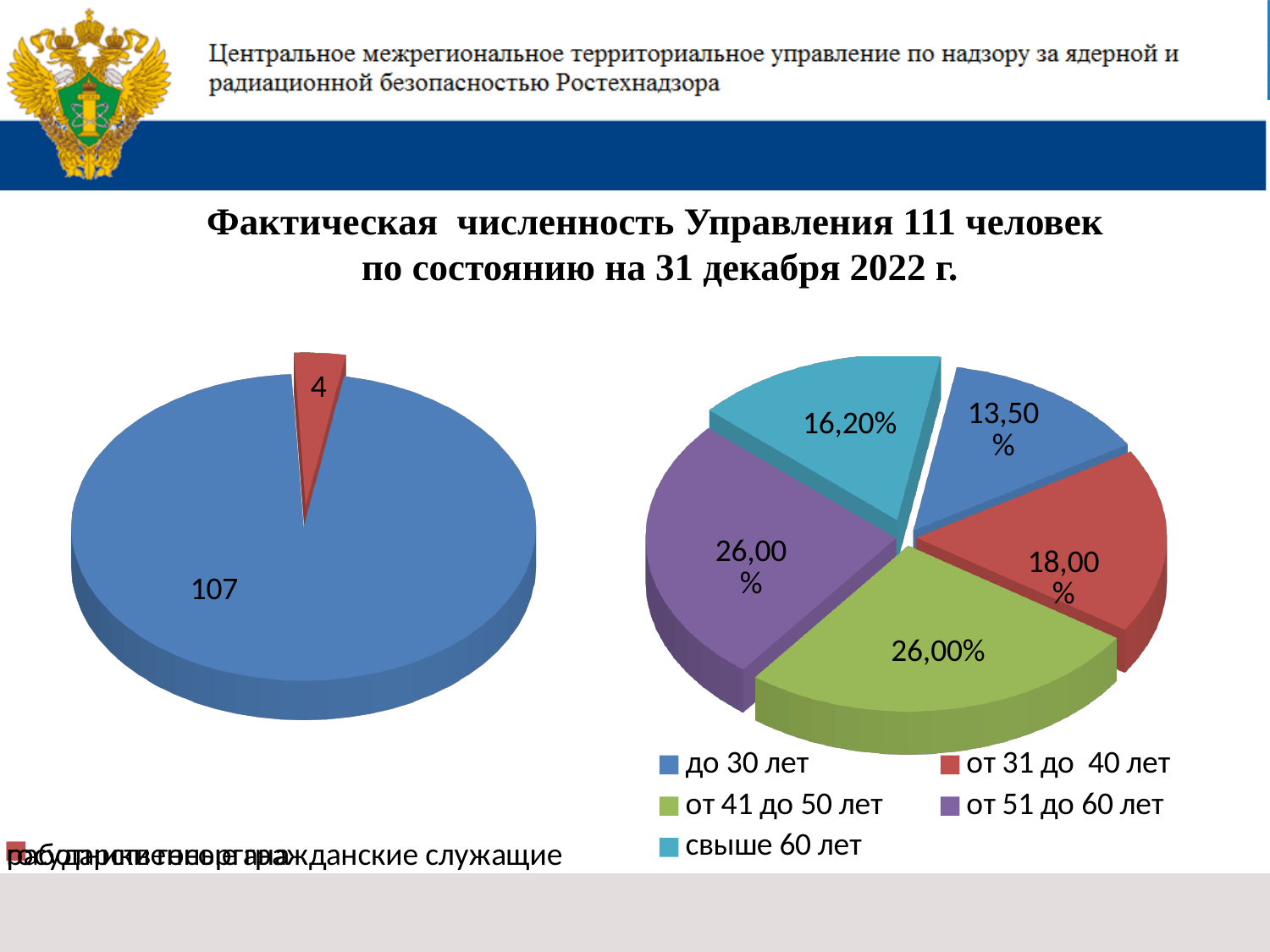
In the right pie chart, what is the share for 'свыше 60 лет'? 16,20% In the right pie chart, which is larger: the share for 'от 31 до 40 лет' or the share for 'свыше 60 лет'? от 31 до 40 лет What kind of chart is the chart on the right of the slide? pie chart In the right pie chart, what is the share for 'от 41 до 50 лет'? 26,00% In the left pie chart, what is the total of the two slices? 111 In the left pie chart, what value is shown on the small red slice? 4 In the right pie chart, which age group has the smallest share? до 30 лет How many age groups does the legend of the right pie chart list? 5 In the right pie chart, what is the share for 'от 31 до 40 лет'? 18,00% In the left pie chart, what value is shown on the large blue slice? 107 In the right pie chart, what is the share for 'до 30 лет'? 13,50% In the right pie chart, what is the difference between the shares for 'от 51 до 60 лет' and 'до 30 лет'? 12,50%